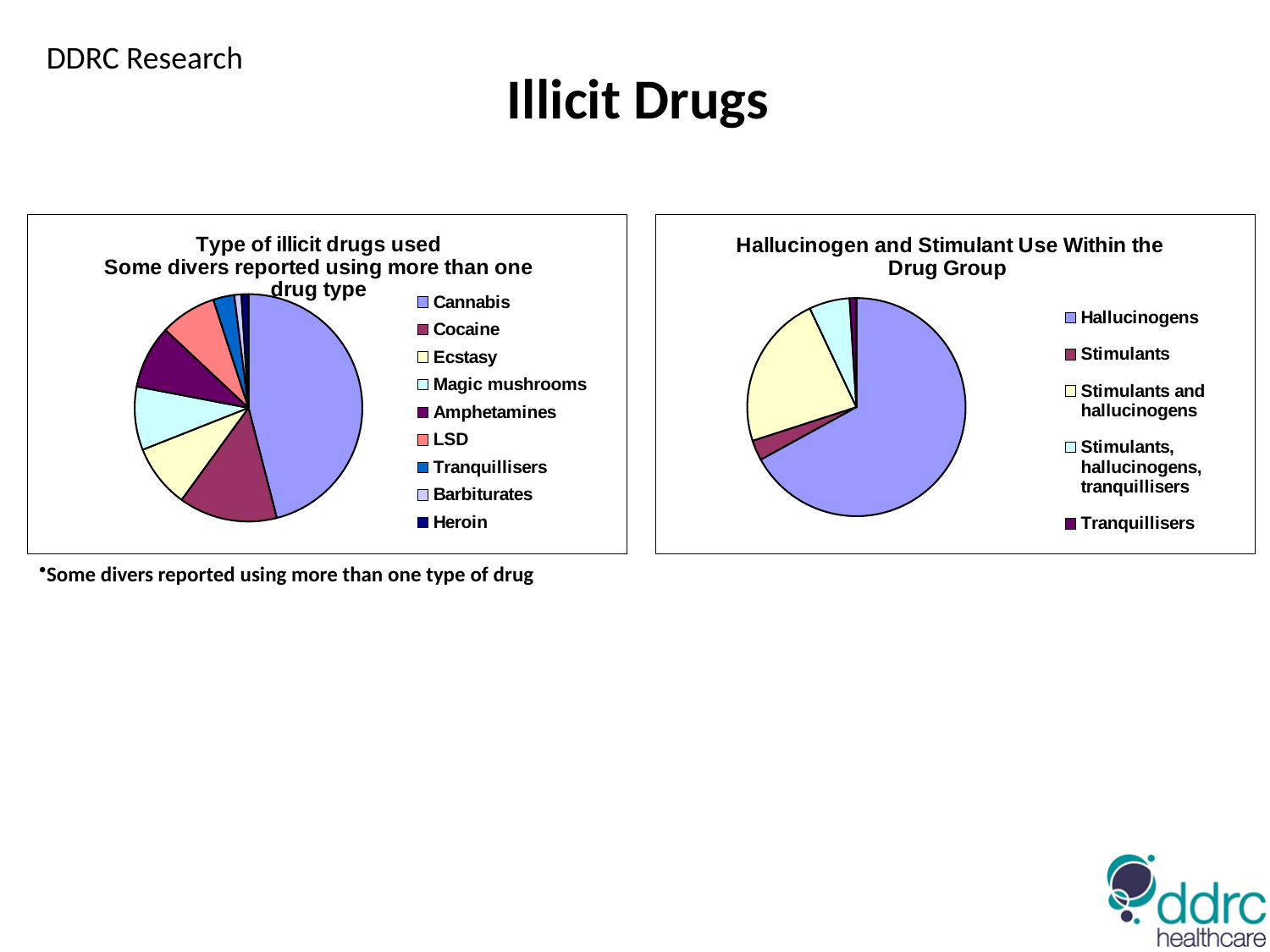
In the 'Hallucinogen and Stimulant Use Within the Drug Group' chart, which slice is larger, 'Stimulants' or 'Stimulants and hallucinogens'? Stimulants and hallucinogens What is the title of the pie chart on the right of the slide? Hallucinogen and Stimulant Use Within the Drug Group In the 'Type of illicit drugs used' chart, which slice is larger, Cocaine or LSD? Cocaine In the 'Hallucinogen and Stimulant Use Within the Drug Group' chart, which category has the smallest slice? Tranquillisers In the 'Type of illicit drugs used' chart, which drug type is shown in the pale yellow slice? Ecstasy In the 'Hallucinogen and Stimulant Use Within the Drug Group' chart, which category has the largest slice? Hallucinogens What kind of chart is the 'Type of illicit drugs used' chart on the left? Pie chart In the 'Type of illicit drugs used' chart, which slice is larger, Ecstasy or Tranquillisers? Ecstasy What kind of chart is the 'Hallucinogen and Stimulant Use Within the Drug Group' chart on the right? Pie chart In the 'Type of illicit drugs used' chart, which drug type has the largest slice? Cannabis In the 'Type of illicit drugs used' chart, how many drug types are listed in the legend? 9 In the 'Hallucinogen and Stimulant Use Within the Drug Group' chart, how many categories are listed in the legend? 5